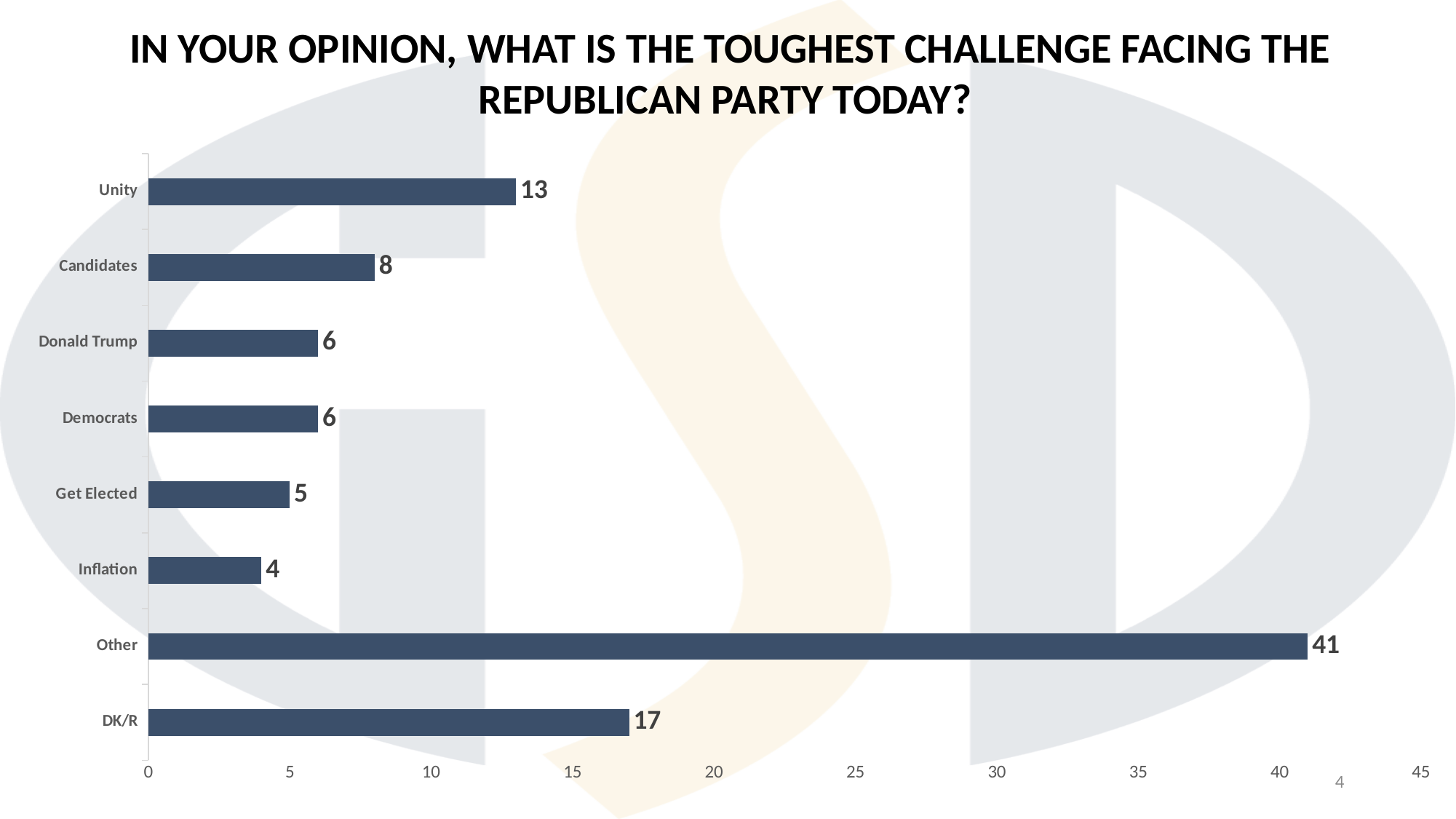
What is the difference between the values for Unity and Candidates? 5 What is the title of the chart? In your opinion, what is the toughest challenge facing the Republican Party today? What kind of chart is shown on the slide? bar chart What is the value for Unity? 13 Which category has the highest value? Other What is the value for Inflation? 4 Which category has the lowest value? Inflation Which is larger, the value for Candidates or the value for Get Elected? Candidates Is the value for Other greater or less than 40? greater How many categories are shown in the chart? 8 What is the difference between the values for Other and DK/R? 24 What is the value for DK/R? 17